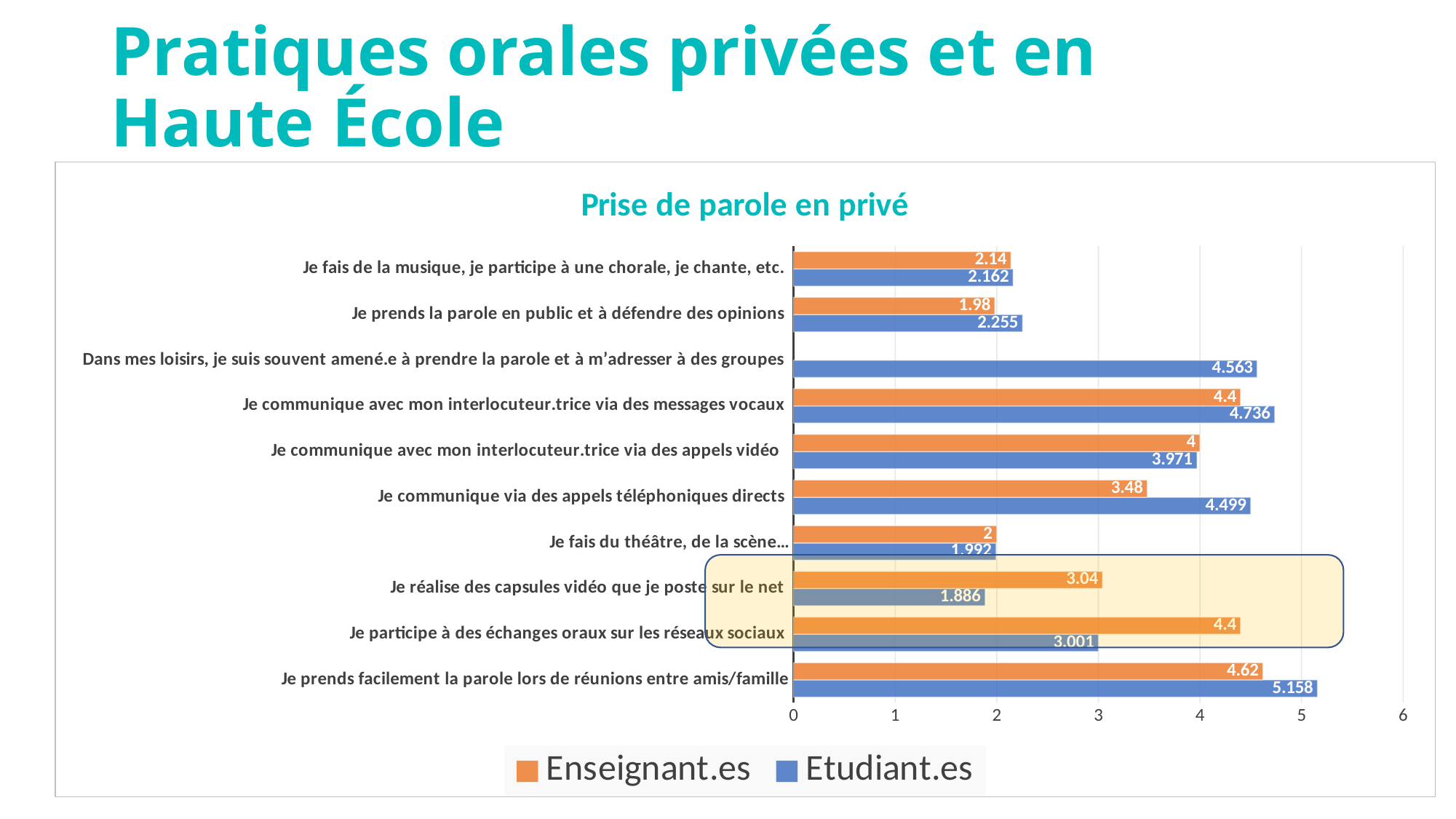
For "Je communique via des appels téléphoniques directs", which series has the larger value, Enseignant.es or Etudiant.es? Etudiant.es What is the difference between the Enseignant.es and Etudiant.es values for "Je participe à des échanges oraux sur les réseaux sociaux"? 1.399 Which category has the highest Etudiant.es value? Je prends facilement la parole lors de réunions entre amis/famille What is the Etudiant.es value for "Je prends facilement la parole lors de réunions entre amis/famille"? 5.158 What is the Enseignant.es value for "Je communique via des appels téléphoniques directs"? 3.48 What is the Etudiant.es value for "Je réalise des capsules vidéo que je poste sur le net"? 1.886 What is the title of the chart? Prise de parole en privé Which category has the lowest Enseignant.es value among those with a bar? Je prends la parole en public et à défendre des opinions How many categories are shown on the chart? 10 Is the Etudiant.es value for "Dans mes loisirs, je suis souvent amené.e à prendre la parole et à m'adresser à des groupes" greater or less than 4? greater How many series does the legend list? 2 What type of chart is shown on the slide? bar chart